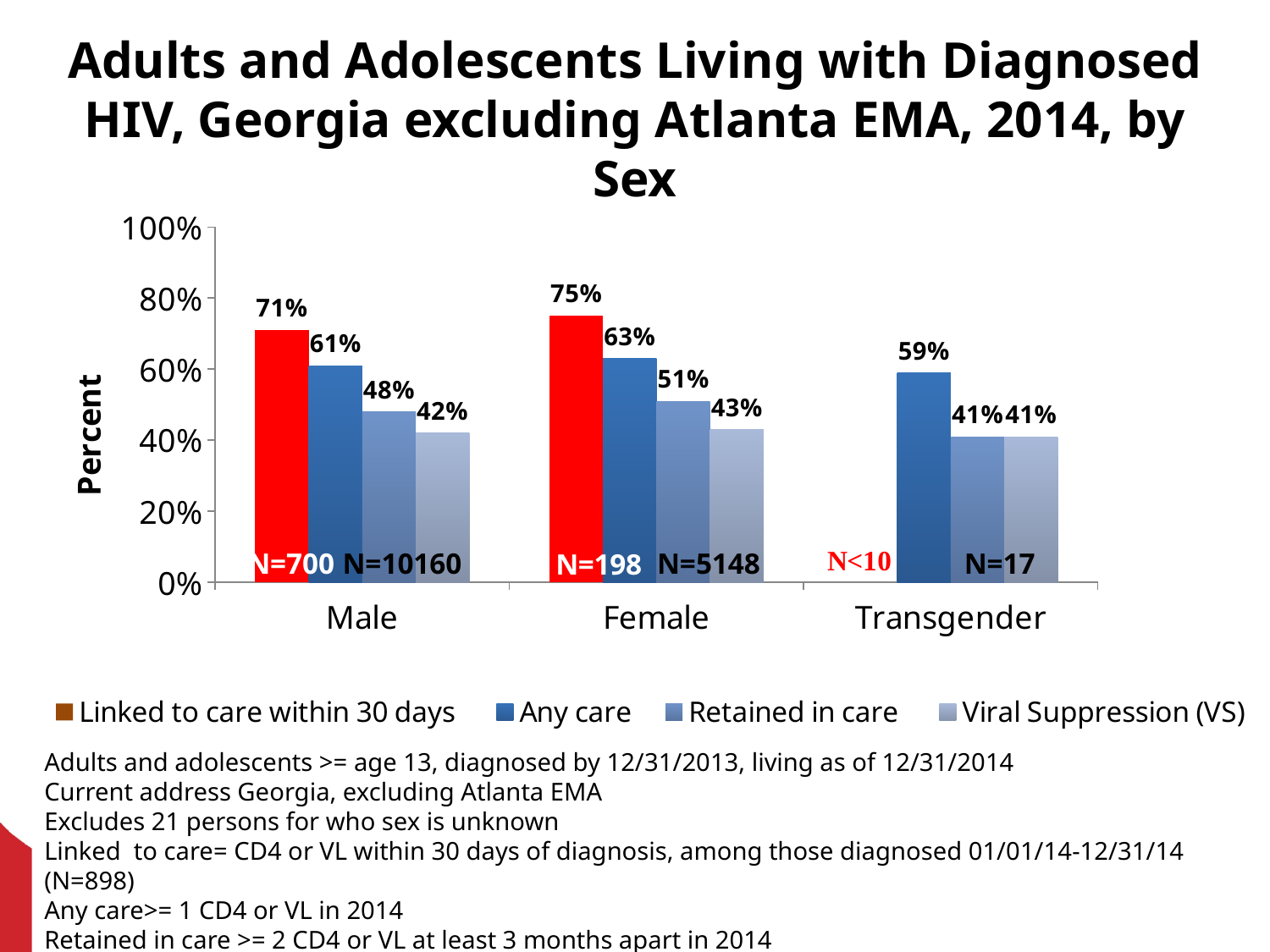
What is the difference between the Linked to care within 30 days values for Females and Males? 4% What is the value for Any care among Males? 61% Which is larger: Retained in care for Males or Retained in care for Females? Female What is the value for Viral Suppression (VS) among Females? 43% Which sex category has the highest value for Any care? Female How many sex categories are shown on the x axis? 3 What is the N shown for Any care among Females? N=5148 What kind of chart is shown on the slide? Bar chart What is the value for Retained in care among Transgender persons? 41% Which sex category has the lowest value for Viral Suppression (VS)? Transgender What is the value for Linked to care within 30 days among Females? 75% How many series does the legend list? 4